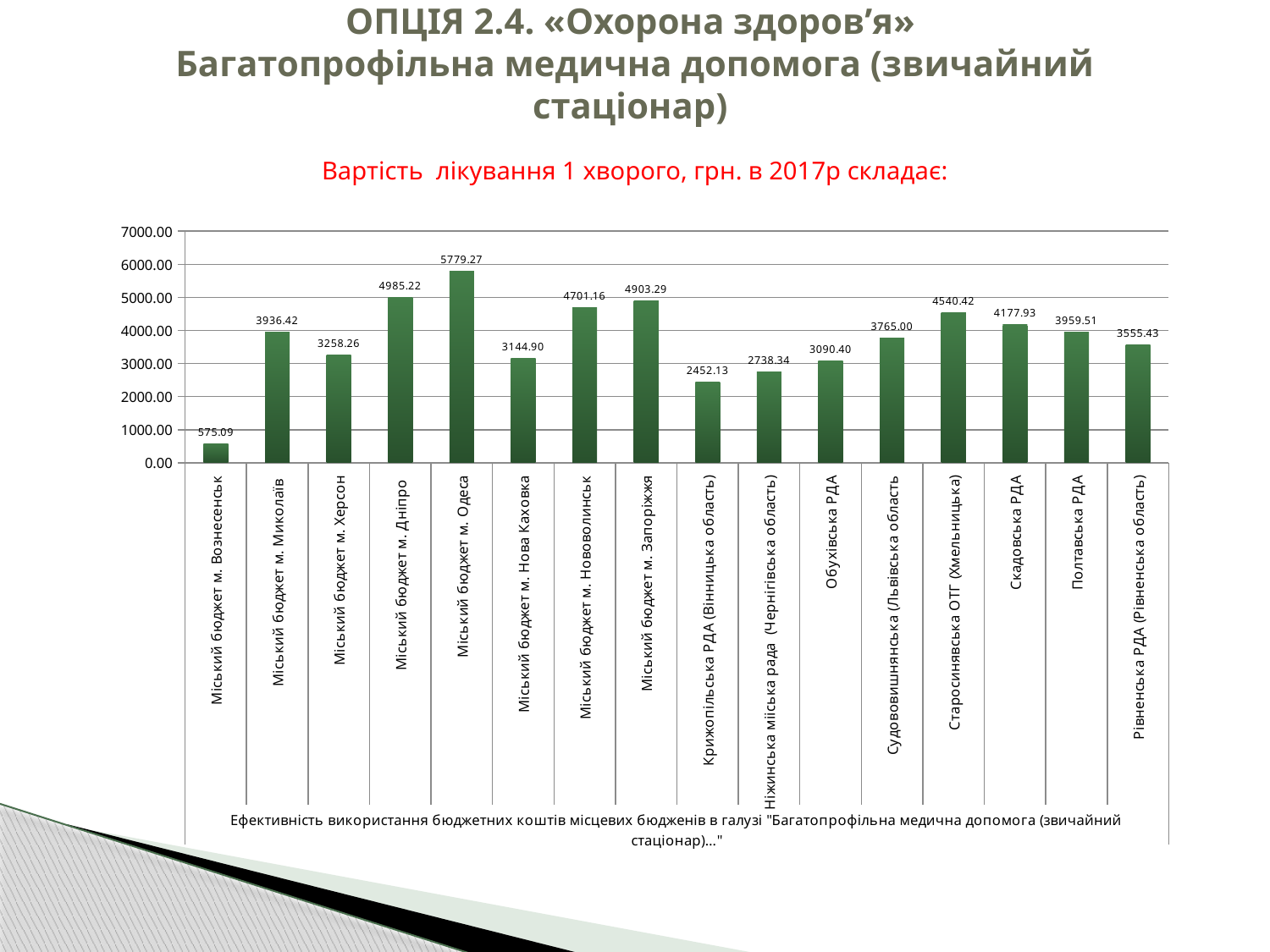
What kind of chart is shown on the slide? bar chart What is the difference between the values for Міський бюджет м. Дніпро and Міський бюджет м. Запоріжжя? 81.93 What is the value for Старосинявська ОТГ (Хмельницька)? 4540.42 Which is larger, the value for Скадовська РДА or the value for Судововишнянська (Львівська область)? Скадовська РДА How many categories are shown on the chart? 16 Which category has the highest value? Міський бюджет м. Одеса What is the value for Міський бюджет м. Одеса? 5779.27 What is the difference between the values for Міський бюджет м. Одеса and Міський бюджет м. Вознесенськ? 5204.18 Is the value for Крижопільська РДА (Вінницька область) greater or less than 3000? less Which category has the lowest value? Міський бюджет м. Вознесенськ What year does the red subtitle above the chart say the treatment cost refers to? 2017 What is the value for Ніжинська міська рада (Чернігівська область)? 2738.34